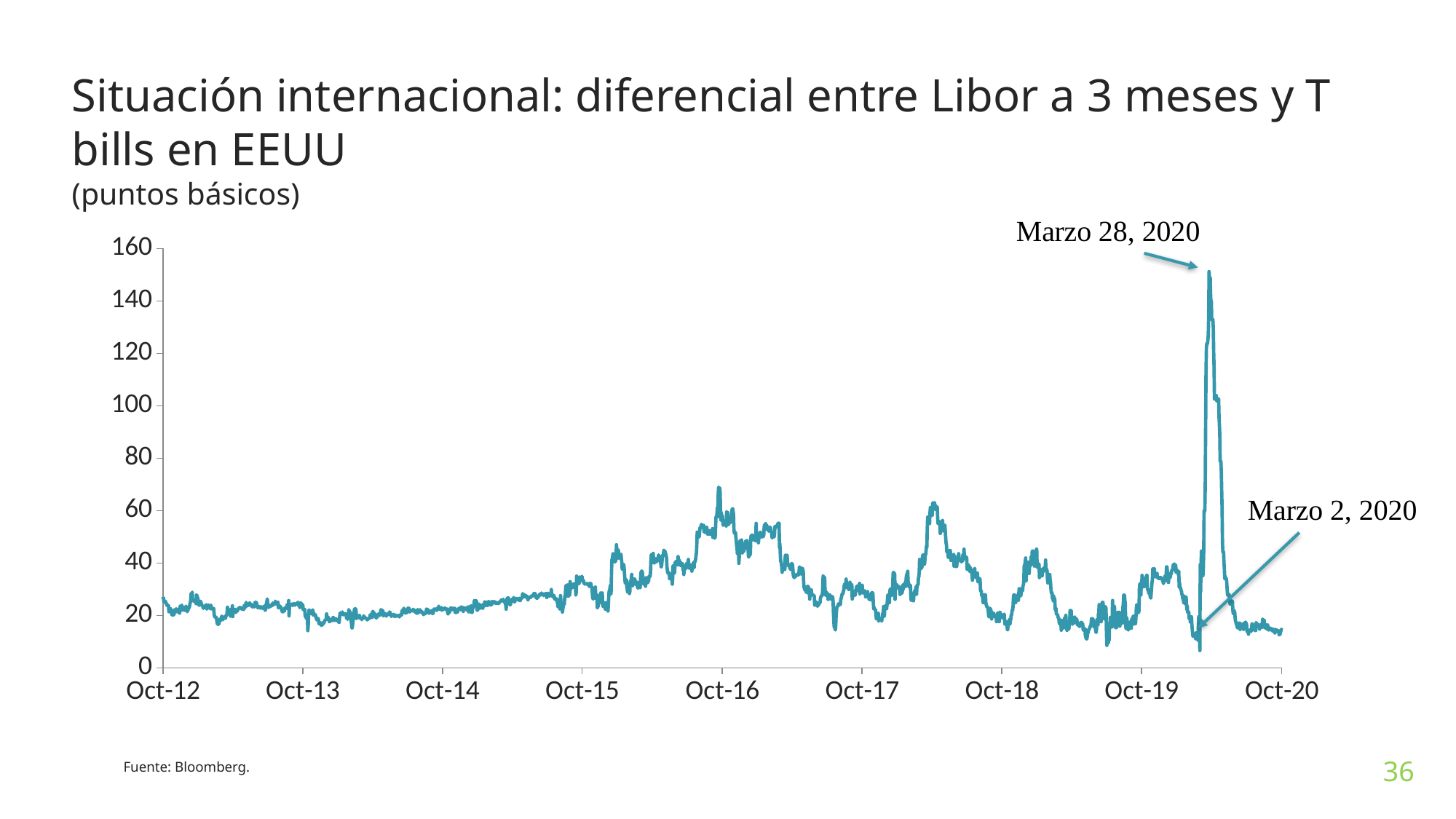
What is the source cited for the chart? Bloomberg Is the value at the point annotated Marzo 28, 2020 larger or smaller than the value at the point annotated Marzo 2, 2020? larger In what units are the values on the chart expressed, according to the subtitle? puntos básicos What is the title of the chart on the slide? Situación internacional: diferencial entre Libor a 3 meses y T bills en EEUU What is the highest value shown on the y axis? 160 Is the value at the end of the series, around Oct-20, greater or less than 40? less What kind of chart is shown on the slide? line chart Which annotated date marks the highest point of the series? Marzo 28, 2020 Is the value at the start of the series, around Oct-12, greater or less than 40? less How many date labels are shown along the x axis? 9 Is the value at the point annotated Marzo 28, 2020 greater or less than 140? greater